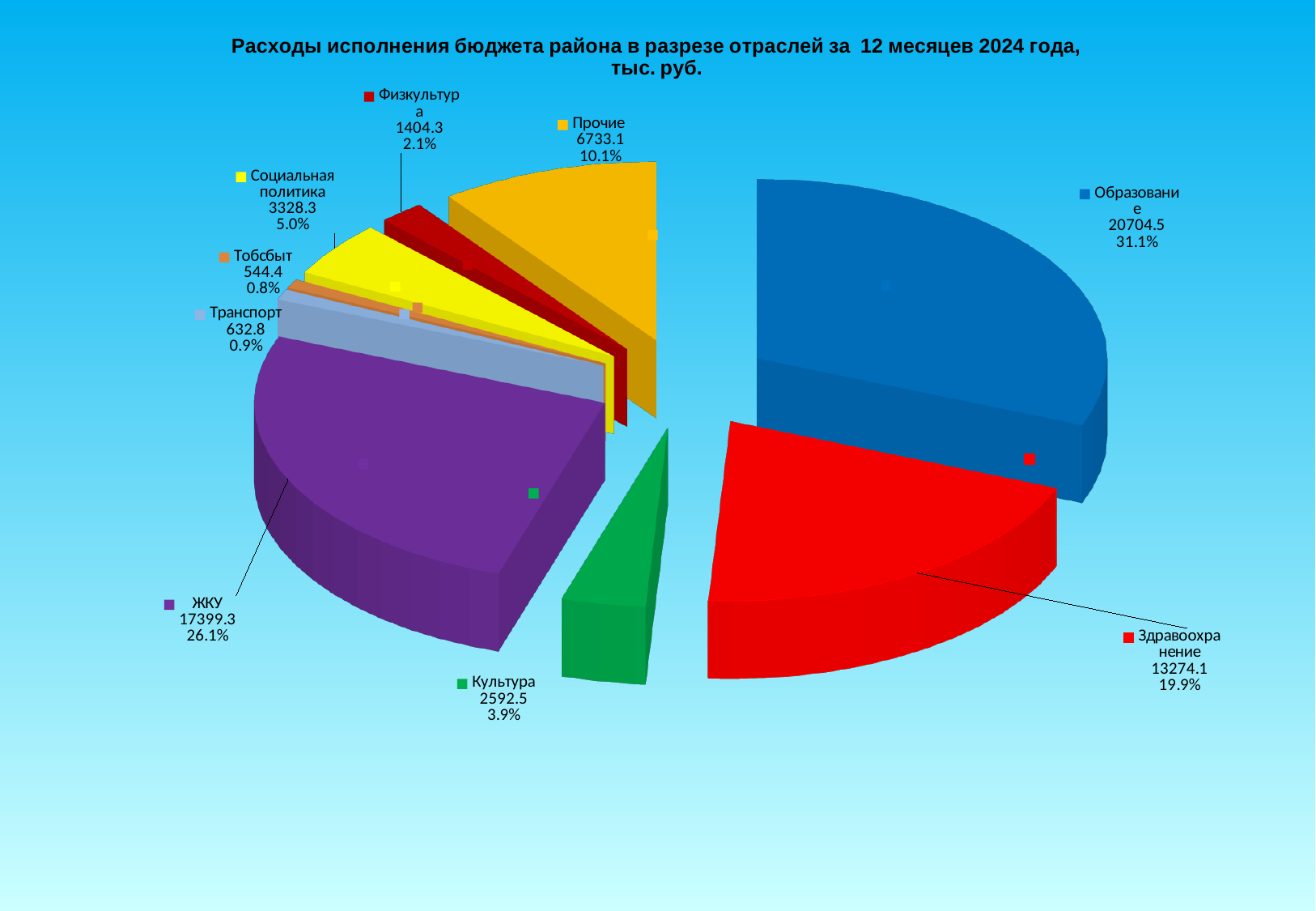
What share of the pie does Прочие represent? 10.1% What kind of chart is shown on the slide? pie chart Which category has the largest slice? Образование What is the value for Здравоохранение? 13274.1 Which category has the smallest slice? Тобсбыт What is the title of the chart? Расходы исполнения бюджета района в разрезе отраслей за 12 месяцев 2024 года, тыс. руб. What is the difference between the values for Образование and ЖКУ? 3305.2 How many categories (slices) does the pie chart show? 9 What is the value for ЖКУ? 17399.3 Which is larger, ЖКУ or Здравоохранение? ЖКУ What is the value for Образование? 20704.5 What share of the pie does Культура represent? 3.9%